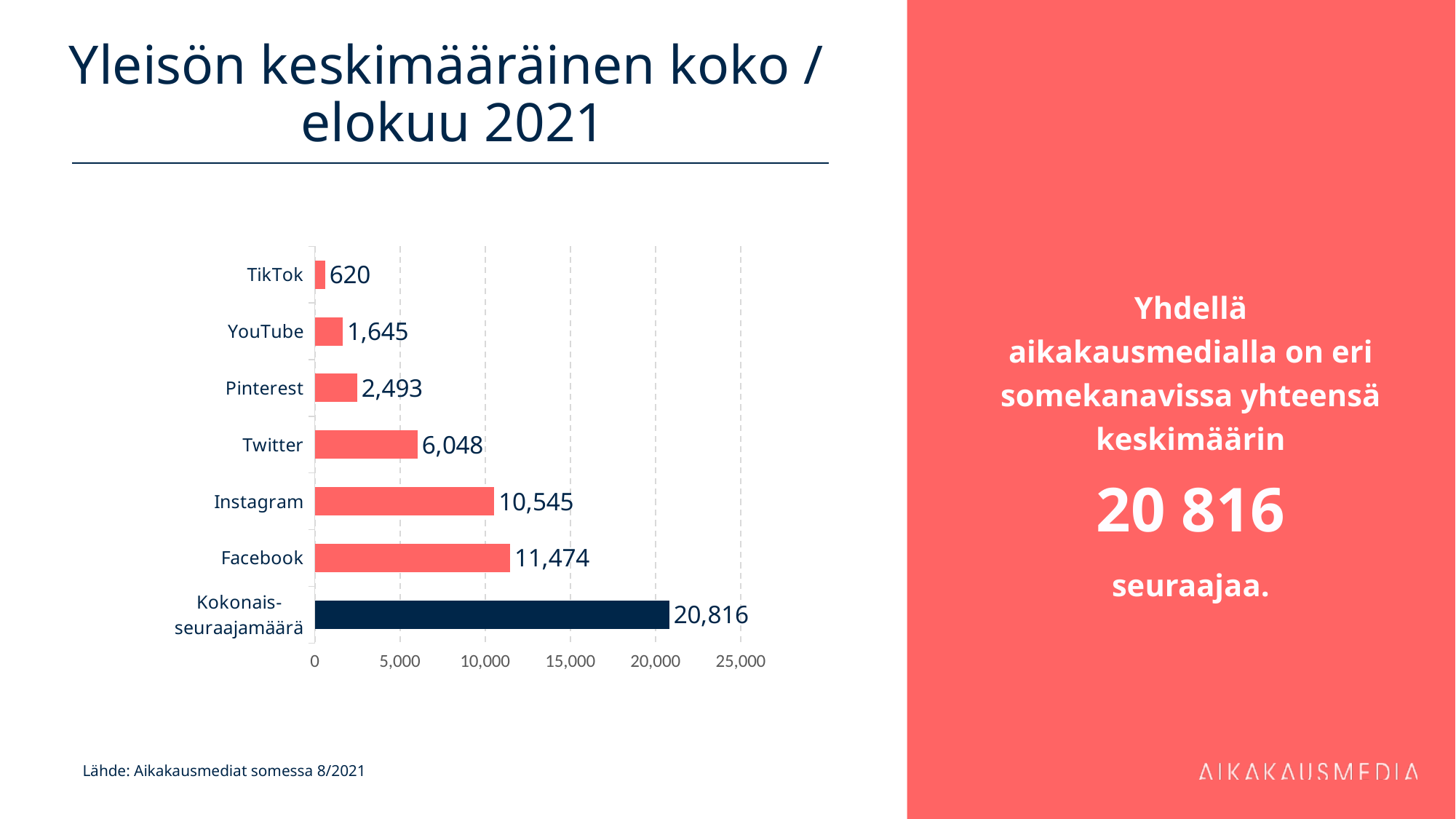
Which is larger, the value for Pinterest or the value for YouTube? Pinterest What is the difference between the values for Facebook and Instagram? 929 What kind of chart is shown on the slide? bar chart What is the value for Facebook? 11,474 What is the value for TikTok? 620 What is the value for Twitter? 6,048 Which category has the highest value? Kokonais-seuraajamäärä Which category has the lowest value? TikTok Is the value for Instagram greater or less than 10,000? greater Which bar is shown in a different colour (dark navy) from the others? Kokonais-seuraajamäärä How many categories are shown in the chart? 7 What is the value for Kokonais-seuraajamäärä? 20,816